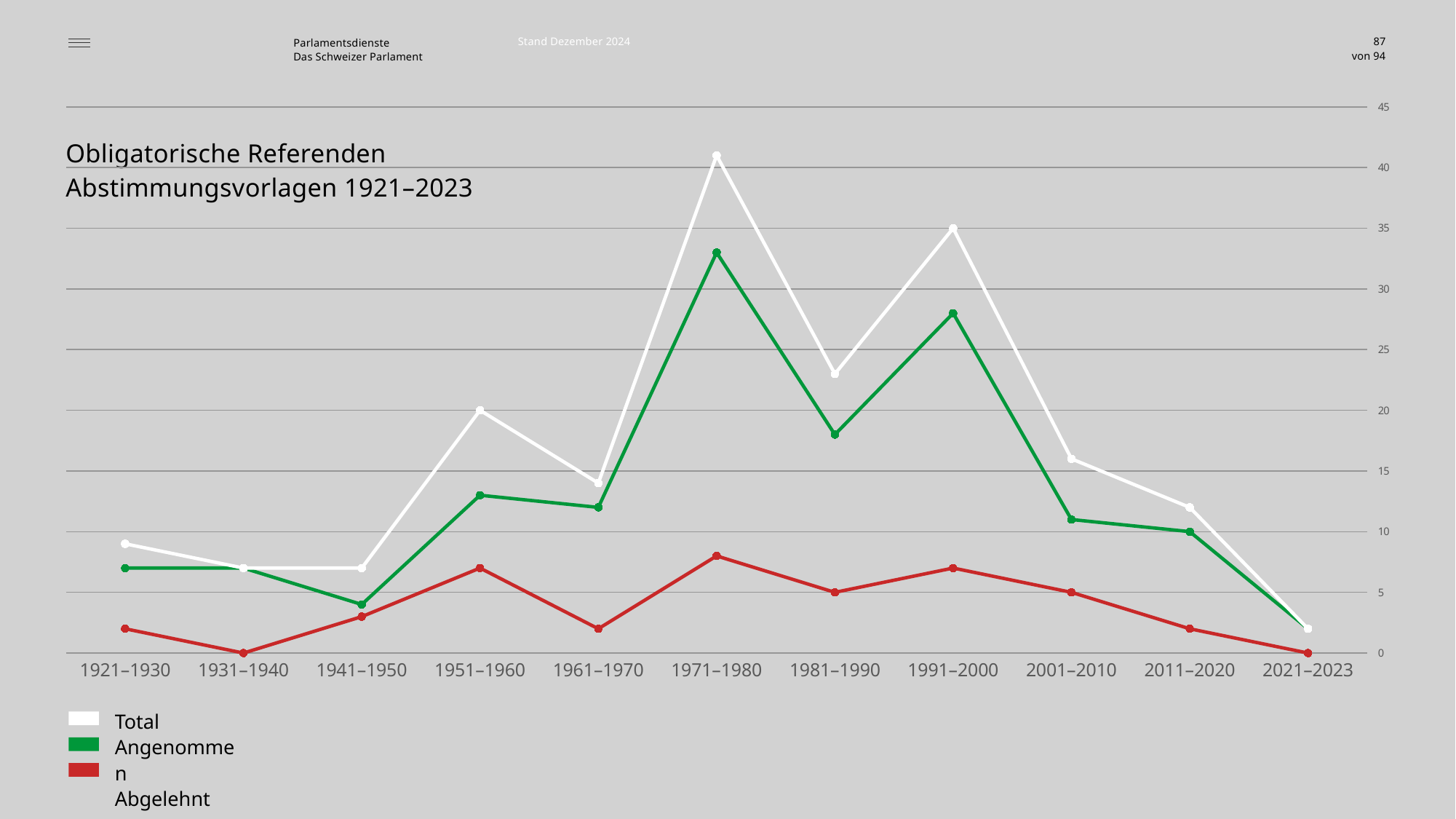
What kind of chart is shown on the slide? line chart What is the Abgelehnt value for 1931–1940? 0 In which period is the Total value lowest? 2021–2023 What is the Angenommen value for 2011–2020? 10 In 1971–1980, which is larger: Angenommen or Abgelehnt? Angenommen How many time periods are shown on the x axis? 11 What is the Total value for 1951–1960? 20 Does the Total line rise or fall from 1991–2000 to 2021–2023? fall How many series does the legend list? 3 In which period is the Total value highest? 1971–1980 Is the Total value for 1971–1980 greater or less than 40? greater What is the Total value for 1991–2000? 35